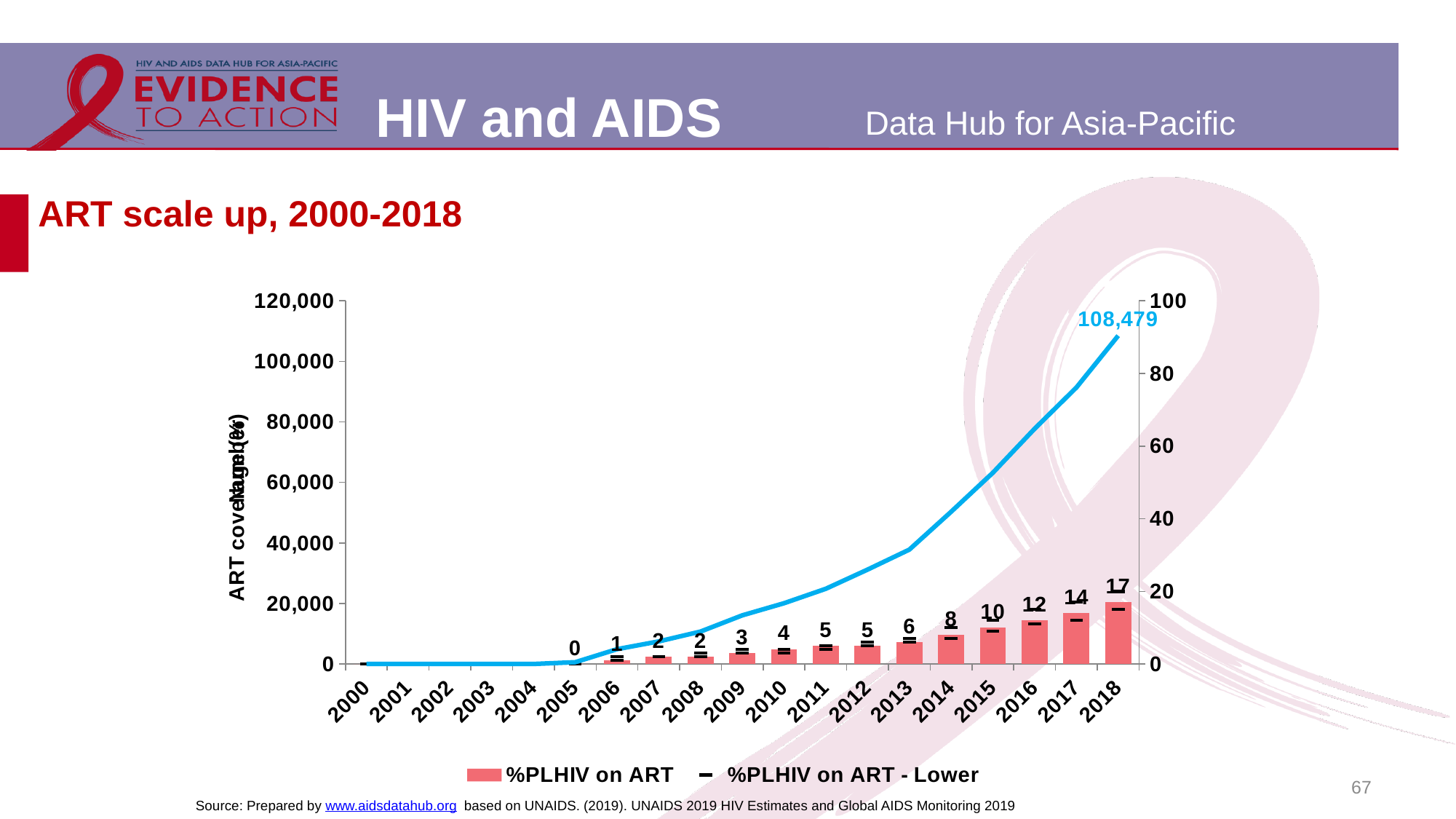
How many series does the legend list? 2 What value is labelled on the blue line at 2018? 108,479 What is the %PLHIV on ART value shown for 2010? 4 What is the %PLHIV on ART value shown for 2015? 10 Does the blue line rise or fall from 2005 to 2018? rise What is the difference between the %PLHIV on ART values for 2018 and 2017? 3 What is the %PLHIV on ART value shown for 2018? 17 Which year has a larger %PLHIV on ART value, 2013 or 2014? 2014 What kind of chart is shown on the slide? Combined bar and line chart Which year has the highest %PLHIV on ART bar? 2018 Is the value of the blue line in 2012 greater or less than 40,000 on the left axis? less How many years are shown on the x axis? 19